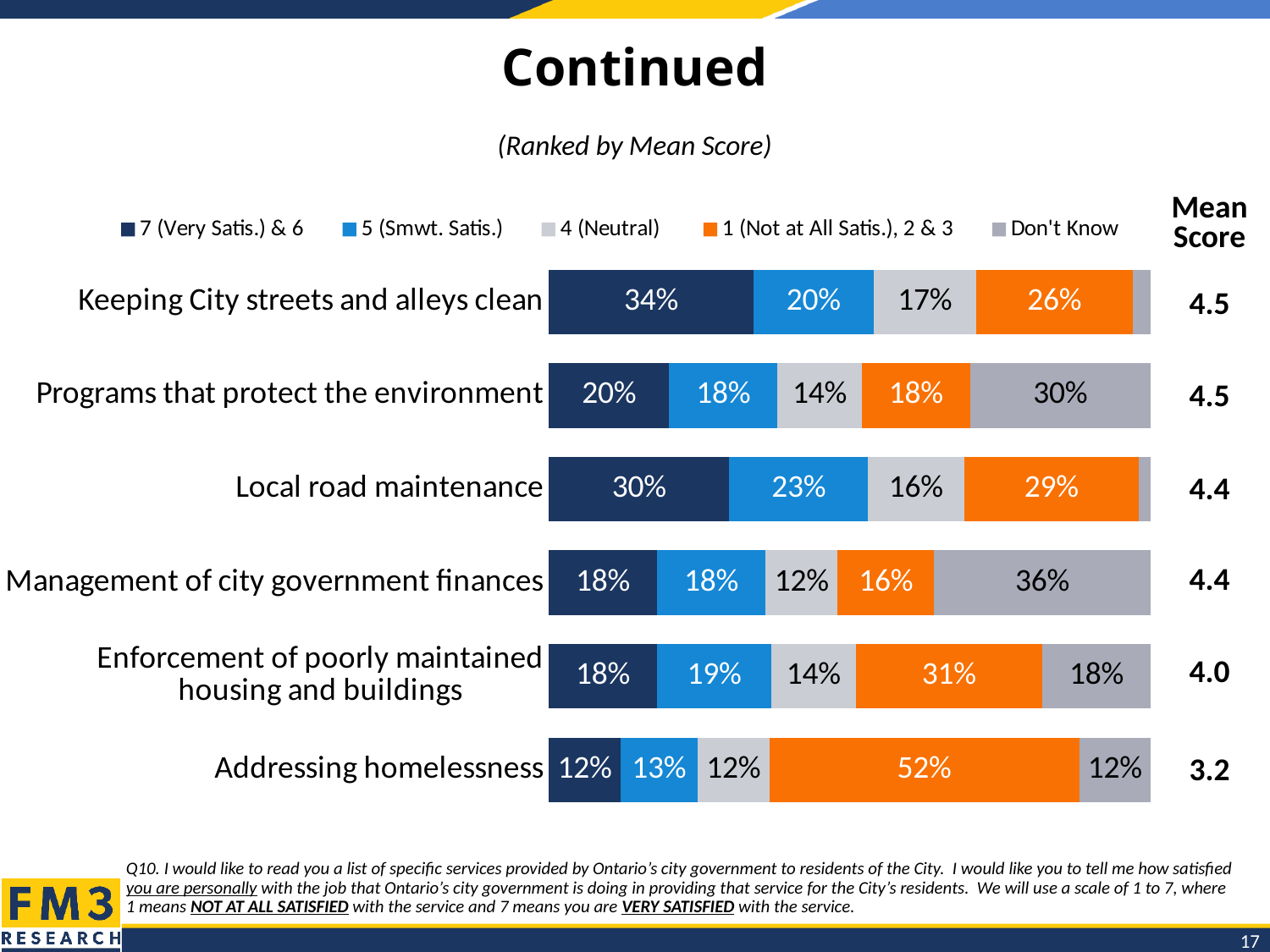
What is the Mean Score shown for Addressing homelessness? 3.2 What kind of chart is shown on the slide? Stacked bar chart What is the "4 (Neutral)" value for Programs that protect the environment? 14% How many series does the chart legend list? 5 Which service has the highest "1 (Not at All Satis.), 2 & 3" value? Addressing homelessness According to the subtitle, how are the services in the chart ranked? By Mean Score What is the difference between the "1 (Not at All Satis.), 2 & 3" values for Addressing homelessness and Enforcement of poorly maintained housing and buildings? 21 percentage points Which has the larger "5 (Smwt. Satis.)" value: Local road maintenance or Keeping City streets and alleys clean? Local road maintenance What is the "7 (Very Satis.) & 6" value for Keeping City streets and alleys clean? 34% Which service has the lowest "7 (Very Satis.) & 6" value? Addressing homelessness How many services (categories) are plotted in the chart? 6 What is the "Don't Know" value for Management of city government finances? 36%